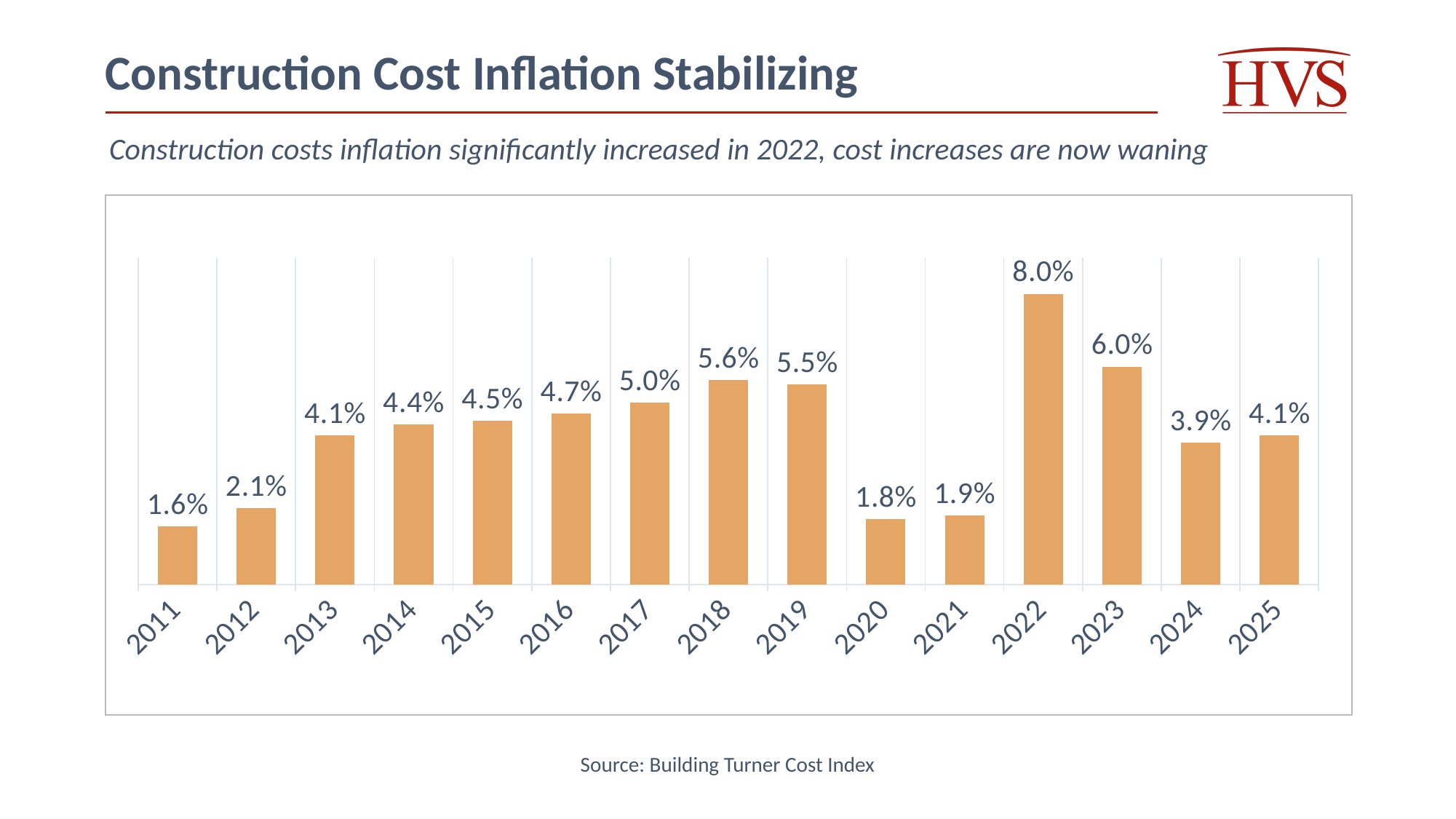
Which year has a larger value, 2018 or 2024? 2018 Do the values rise or fall from 2022 to 2024? Fall What is the construction cost inflation value for 2022? 8.0% What is the difference between the values for 2022 and 2023? 2.0% What kind of chart is shown on the slide? Bar chart How many years are shown on the x axis? 15 What is the value shown for 2011? 1.6% Which year has the lowest construction cost inflation? 2011 What is the value shown for 2025? 4.1% What is the source cited below the chart? Building Turner Cost Index What is the difference between the values for 2019 and 2020? 3.7% Which year has the highest construction cost inflation? 2022